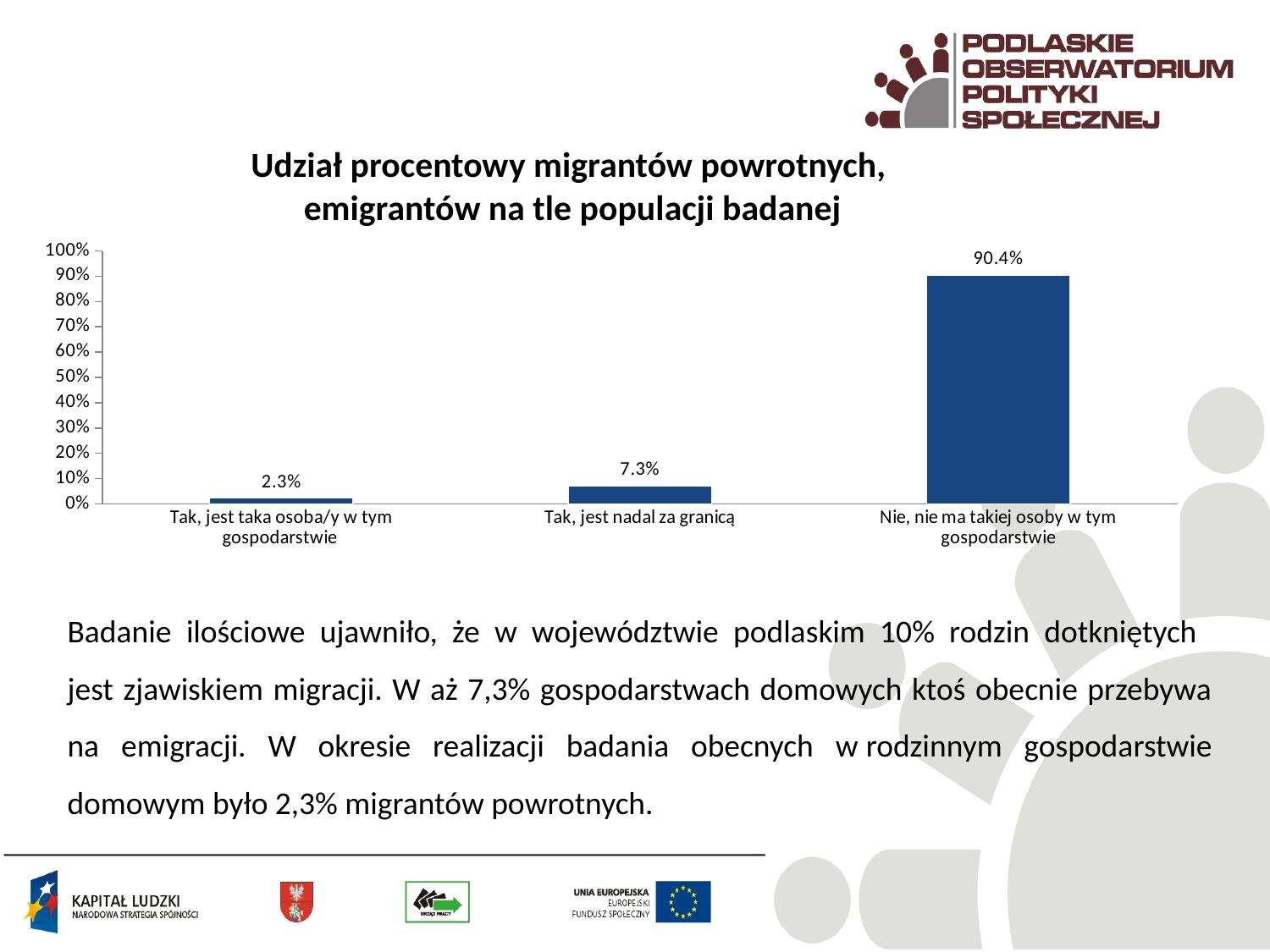
What is the title of the chart? Udział procentowy migrantów powrotnych, emigrantów na tle populacji badanej What is the value for "Nie, nie ma takiej osoby w tym gospodarstwie"? 90.4% Is the value for "Nie, nie ma takiej osoby w tym gospodarstwie" greater or less than 80%? greater Which category has the lowest value? Tak, jest taka osoba/y w tym gospodarstwie Which category has the highest value? Nie, nie ma takiej osoby w tym gospodarstwie How many categories are shown on the x axis? 3 Which is larger: the value for "Tak, jest nadal za granicą" or for "Tak, jest taka osoba/y w tym gospodarstwie"? Tak, jest nadal za granicą What is the difference between the values for "Tak, jest nadal za granicą" and "Tak, jest taka osoba/y w tym gospodarstwie"? 5.0% What is the value for "Tak, jest nadal za granicą"? 7.3% What is the difference between the values for "Nie, nie ma takiej osoby w tym gospodarstwie" and "Tak, jest nadal za granicą"? 83.1% What is the value for "Tak, jest taka osoba/y w tym gospodarstwie"? 2.3% What kind of chart is shown on the slide? bar chart